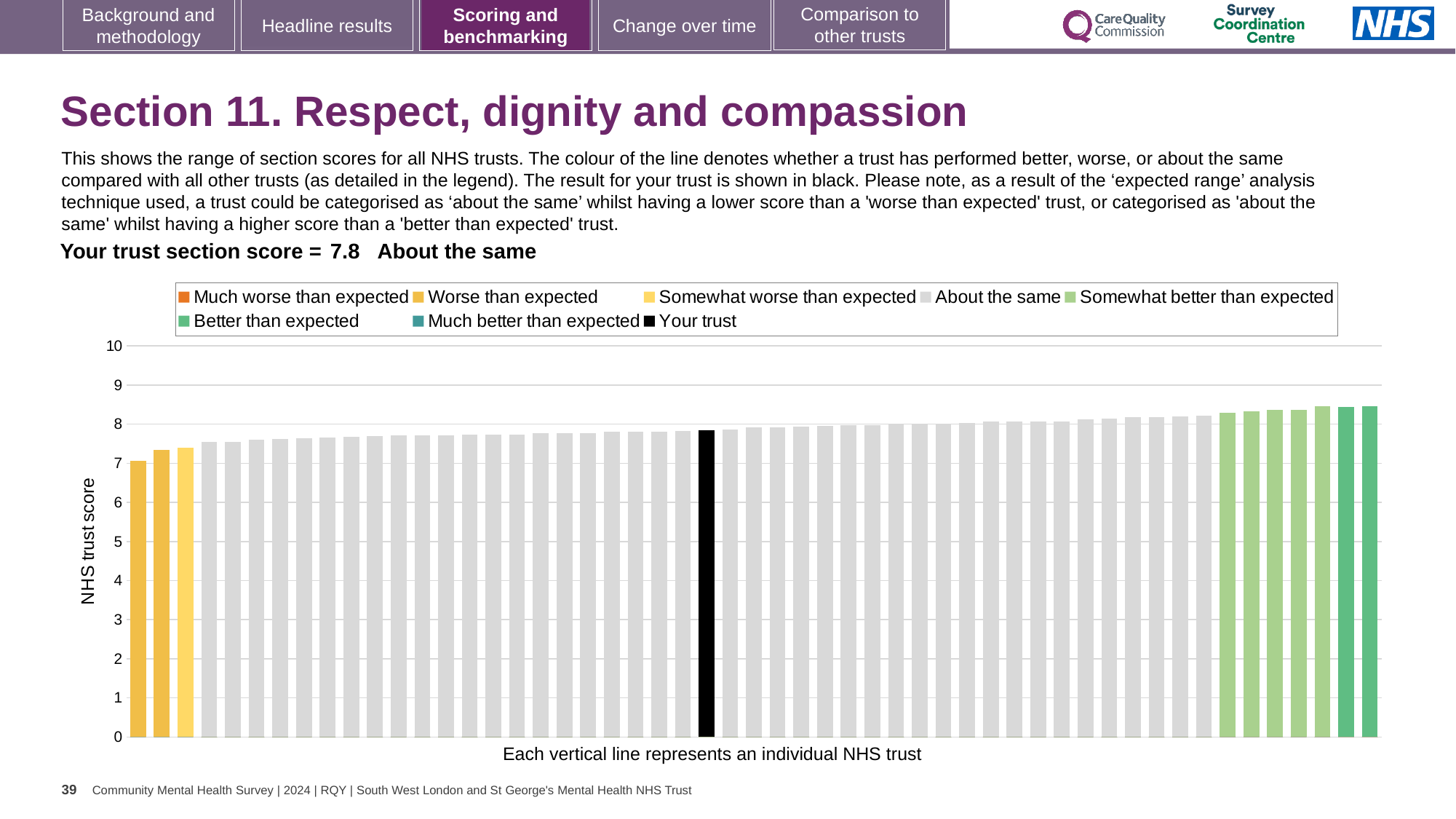
What is the label on the vertical axis of the chart? NHS trust score Which performance category is your trust placed in for Section 11? About the same What is the section score for your trust shown on the slide? 7.8 How many bars are coloured as 'Worse than expected' (the darker yellow bars)? 2 Do the trust scores rise or fall from left to right along the x axis? rise Is the value for the lowest-scoring trust (the leftmost bar) greater or less than 8? less Is the value for your trust (the black bar) greater or less than 7? greater Is the value for the highest-scoring trust (the rightmost bar) greater or less than 8? greater Which legend category do the highest-scoring trusts on the right of the chart belong to? Better than expected What colour is the bar representing your trust? black What kind of chart is shown on the slide? bar chart How many entries does the chart legend list? 8